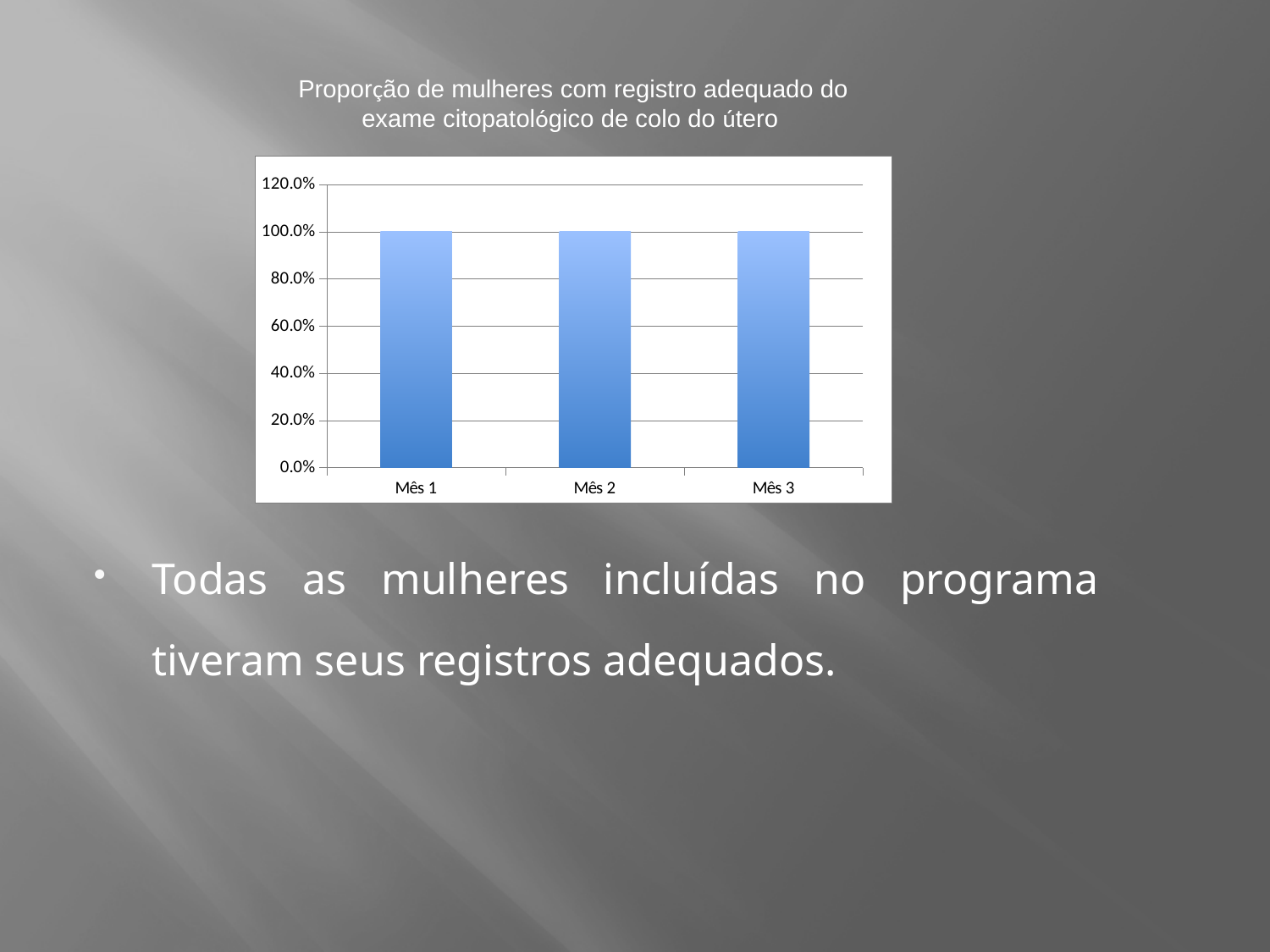
Do the values rise, fall or stay the same from Mês 1 to Mês 3? stay the same What is the difference between the values for Mês 1 and Mês 2? 0.0% What is the title of the chart? Proporção de mulheres com registro adequado do exame citopatológico de colo do útero Is the value for Mês 1 greater or less than 80.0%? greater What is the value for Mês 1? 100.0% What kind of chart is shown on the slide? bar chart What is the value for Mês 3? 100.0% What is the highest value shown on the y axis of the chart? 120.0% How many categories are shown on the x axis of the chart? 3 Is the value for Mês 3 greater or less than 120.0%? less What is the value for Mês 2? 100.0%